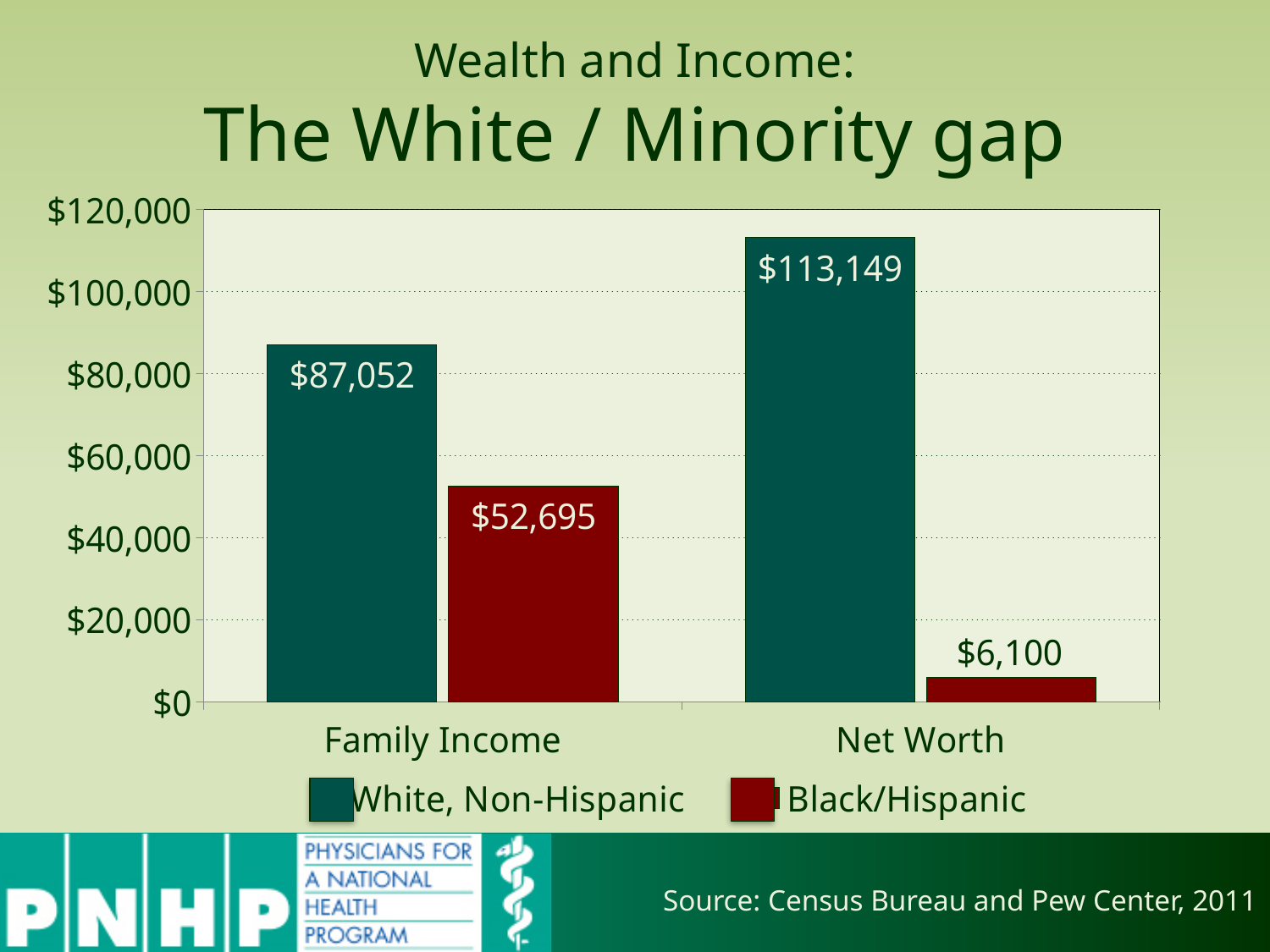
What is the Net Worth value for Black/Hispanic? $6,100 How many series does the legend list? 2 Which is larger: the Black/Hispanic Family Income or the Black/Hispanic Net Worth? Black/Hispanic Family Income What is the Family Income value for White, Non-Hispanic? $87,052 What kind of chart is shown on the slide? Bar chart What is the difference between the White, Non-Hispanic and Black/Hispanic Family Income values? $34,357 Which bar has the lowest value on the chart? Black/Hispanic Net Worth Which bar has the highest value on the chart? White, Non-Hispanic Net Worth What is the Net Worth value for White, Non-Hispanic? $113,149 What colour are the Black/Hispanic bars? Dark red What is the difference between the White, Non-Hispanic and Black/Hispanic Net Worth values? $107,049 What is the Family Income value for Black/Hispanic? $52,695